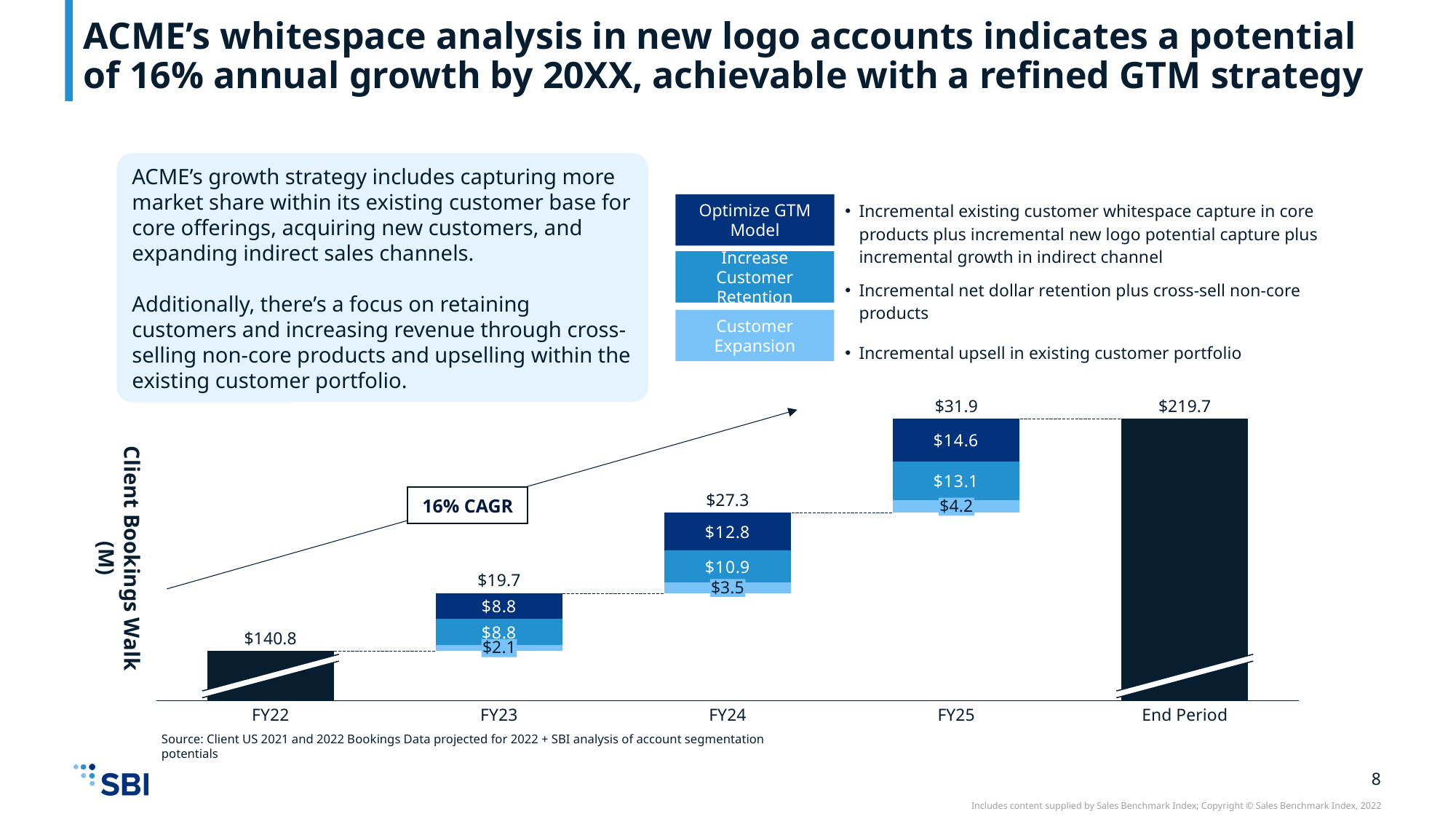
What is the value shown for End Period in the Client Bookings Walk chart? $219.7 What is the value shown for FY22 in the Client Bookings Walk chart? $140.8 How many series does the legend list? 3 What is the Optimize GTM Model (dark blue) segment value for FY25? $14.6 What is the Increase Customer Retention (medium blue) segment value for FY24? $10.9 What CAGR is labelled on the arrow in the chart? 16% CAGR What is the Customer Expansion (light blue) segment value for FY23? $2.1 What is the difference between the End Period value and the FY22 value? $78.9 Which fiscal year among FY23, FY24 and FY25 has the largest incremental total? FY25 How many categories are shown on the x axis of the chart? 5 What is the total labelled above the FY24 bar? $27.3 Is the Optimize GTM Model segment for FY24 larger or smaller than the Increase Customer Retention segment for FY24? larger